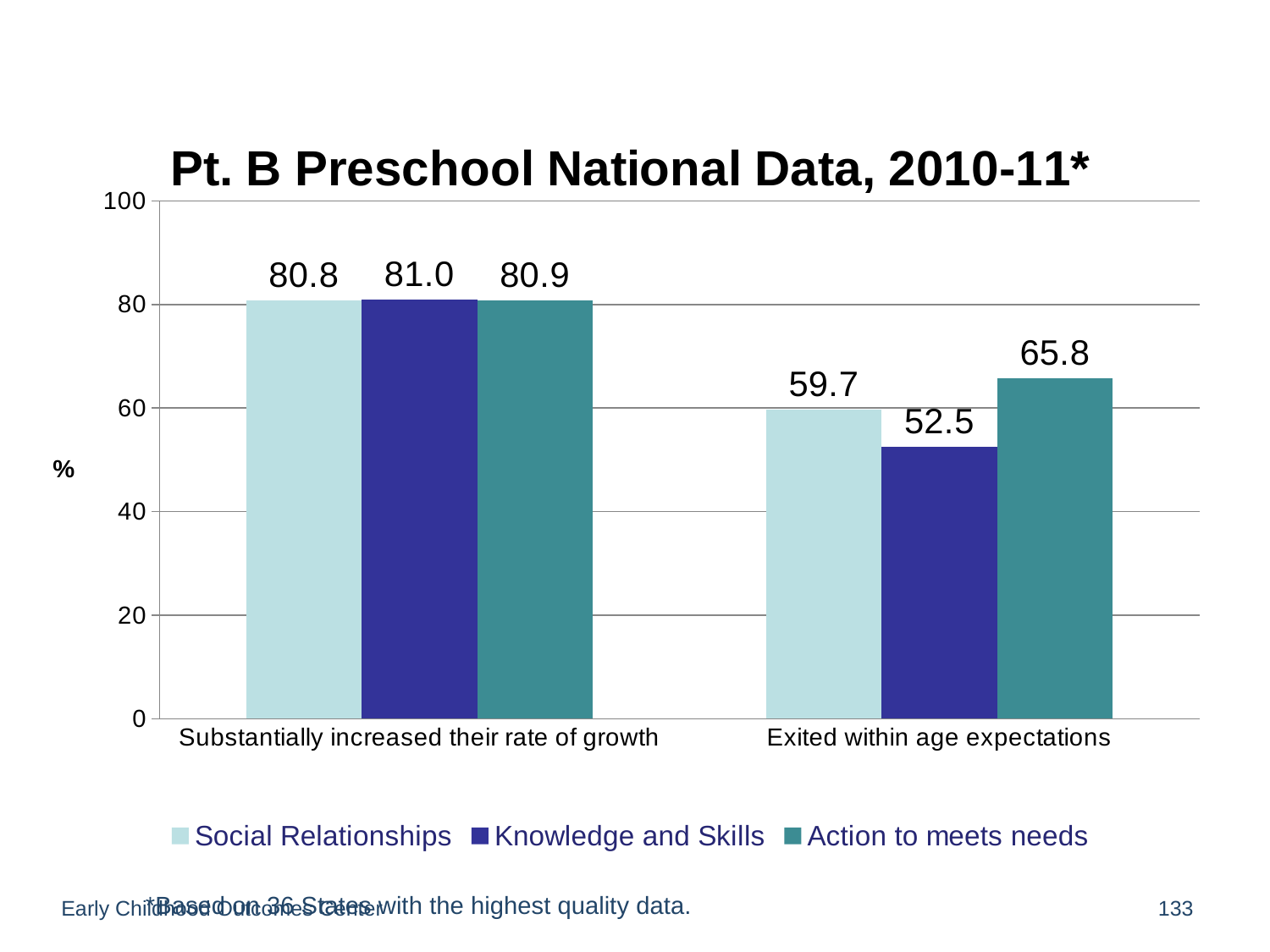
What is the value for Action to meets needs in the 'Exited within age expectations' category? 65.8 Which series has the lowest value in the 'Exited within age expectations' category? Knowledge and Skills How many series does the legend list? 3 What kind of chart is shown on the slide? Bar chart What is the difference between the Social Relationships values for 'Substantially increased their rate of growth' and 'Exited within age expectations'? 21.1 What is the value for Social Relationships in the 'Substantially increased their rate of growth' category? 80.8 How many categories are shown on the x axis? 2 What is the value for Knowledge and Skills in the 'Exited within age expectations' category? 52.5 What is the difference between the Action to meets needs and Knowledge and Skills values in the 'Exited within age expectations' category? 13.3 What is the title of the chart? Pt. B Preschool National Data, 2010-11* Which is larger: Social Relationships for 'Exited within age expectations' or Knowledge and Skills for 'Exited within age expectations'? Social Relationships Which series has the highest value in the 'Exited within age expectations' category? Action to meets needs